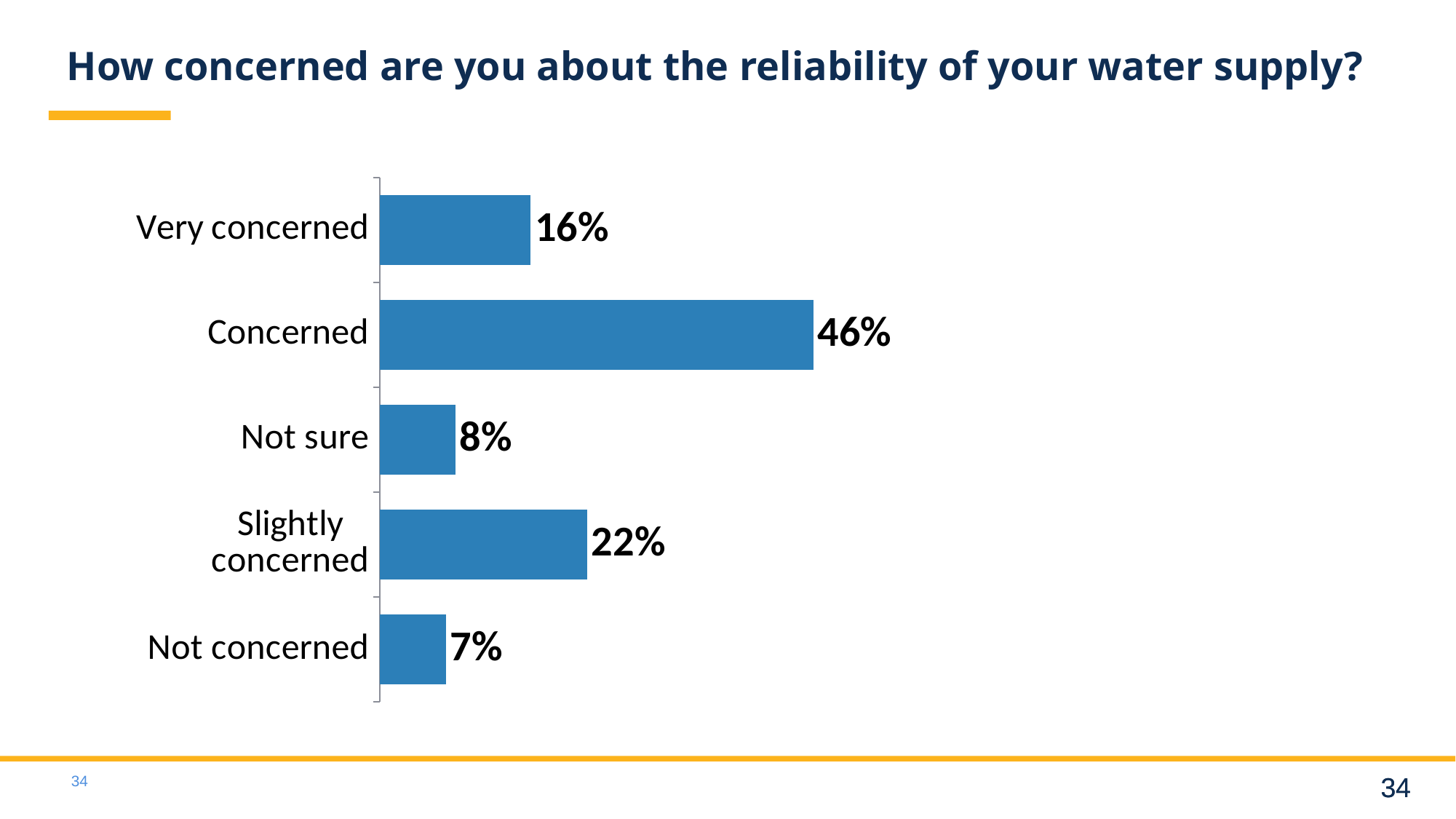
How many response categories are shown in the chart? 5 What percentage of respondents are slightly concerned? 22% What percentage of respondents are very concerned about the reliability of their water supply? 16% Which is larger, the percentage for 'Very concerned' or for 'Slightly concerned'? Slightly concerned What kind of chart is shown on the slide? Bar chart Which response category has the lowest percentage? Not concerned Which response category has the highest percentage? Concerned What percentage of respondents are not concerned? 7% What is the difference in percentage points between 'Slightly concerned' and 'Not concerned'? 15 What percentage of respondents answered 'Concerned'? 46% What percentage of respondents answered 'Not sure'? 8% What is the difference in percentage points between 'Concerned' and 'Very concerned'? 30